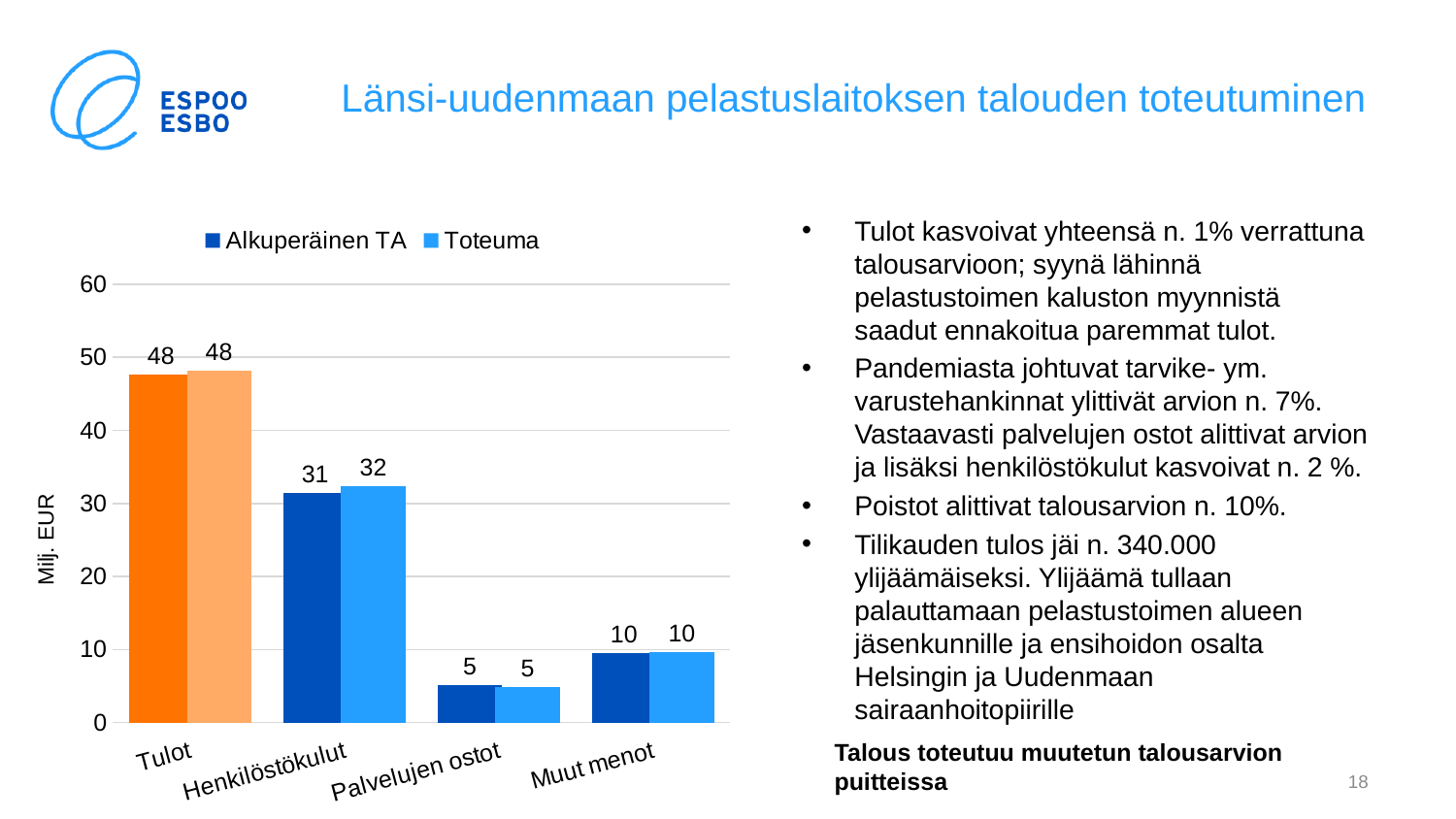
Which category has the lowest Alkuperäinen TA value? Palvelujen ostot What is the difference between the Toteuma and Alkuperäinen TA values for Henkilöstökulut? 1 Which category has the highest Toteuma value? Tulot Which is larger: the Alkuperäinen TA value for Muut menot or for Palvelujen ostot? Muut menot How many categories are shown on the x axis? 4 What is the Alkuperäinen TA value for Henkilöstökulut? 31 What is the label of the y axis? Milj. EUR What kind of chart is shown on the slide? Bar chart How many series does the legend list? 2 What is the Toteuma value for Tulot? 48 What is the Alkuperäinen TA value for Muut menot? 10 What is the Toteuma value for Henkilöstökulut? 32